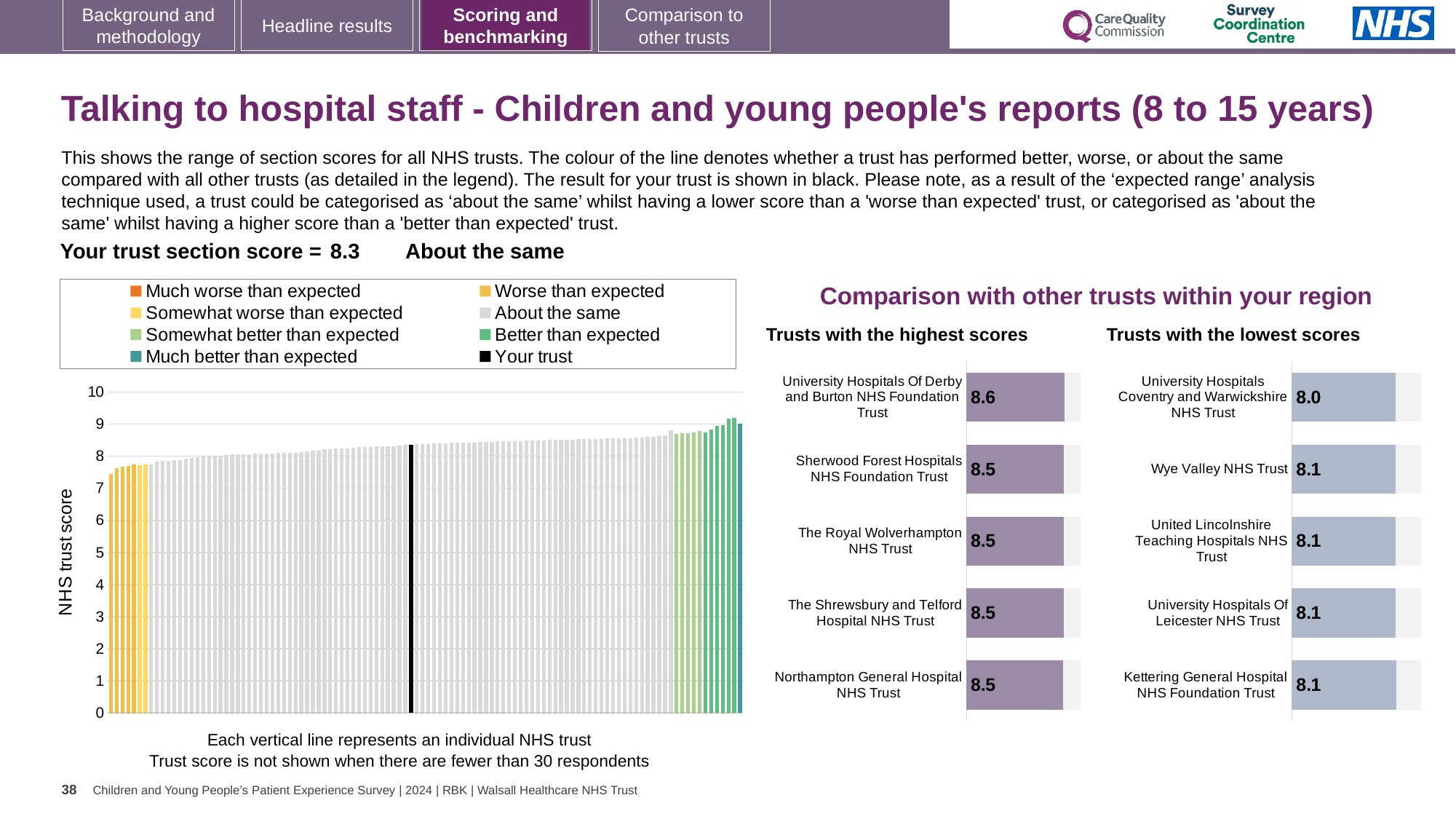
What kind of chart is the main chart showing NHS trust scores on the left of the slide? bar chart In the 'Trusts with the lowest scores' chart, what is the score for University Hospitals Coventry and Warwickshire NHS Trust? 8.0 How many trusts are shown in the 'Trusts with the highest scores' chart? 5 In the 'Trusts with the highest scores' chart, which trust has the highest score? University Hospitals Of Derby and Burton NHS Foundation Trust In the main NHS trust score chart, are the values for the 'Worse than expected' trusts greater or less than 8? less In the 'Trusts with the highest scores' chart, what is the score for University Hospitals Of Derby and Burton NHS Foundation Trust? 8.6 In the 'Trusts with the lowest scores' chart, what is the score for Kettering General Hospital NHS Foundation Trust? 8.1 In the 'Trusts with the highest scores' chart, what is the difference between the scores of University Hospitals Of Derby and Burton NHS Foundation Trust and Sherwood Forest Hospitals NHS Foundation Trust? 0.1 Which is larger: the score for University Hospitals Of Derby and Burton NHS Foundation Trust in the highest scores chart, or the score for University Hospitals Coventry and Warwickshire NHS Trust in the lowest scores chart? University Hospitals Of Derby and Burton NHS Foundation Trust How many entries does the legend of the main NHS trust score chart list? 8 What is the label on the vertical axis of the main chart on the left of the slide? NHS trust score In the 'Trusts with the lowest scores' chart, which trust has the lowest score? University Hospitals Coventry and Warwickshire NHS Trust